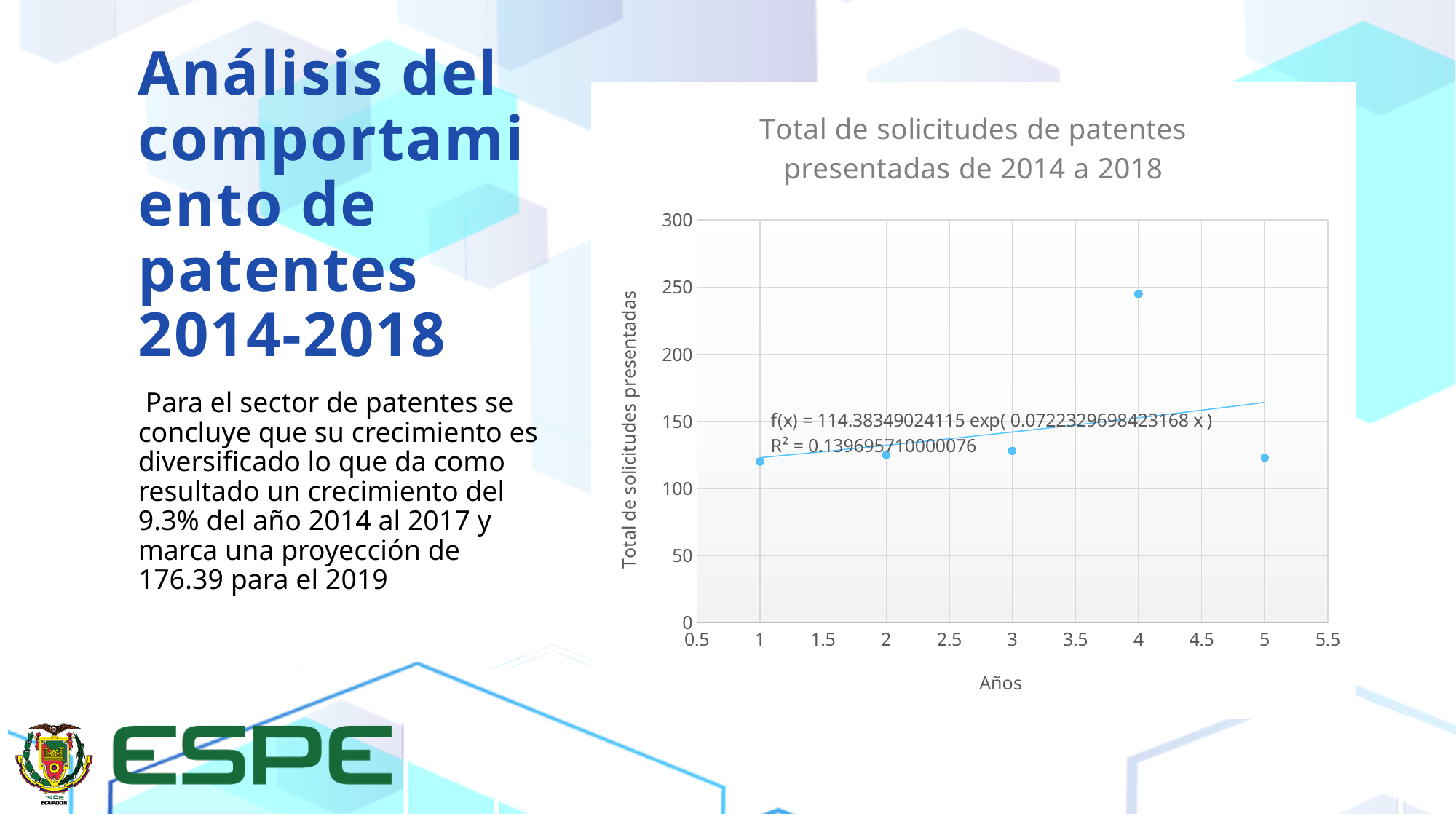
At which x value (Años) is the highest point plotted? 4 What R² value is printed on the chart for the trendline? R² = 0.139695710000076 Is the value at x = 1 greater or less than 150? less What is the label of the vertical axis? Total de solicitudes presentadas How many data points are plotted in the chart? 5 Is the value at x = 4 greater or less than 200? greater Which point has a larger value, the one at x = 2 or the one at x = 4? x = 4 What is the title of the chart? Total de solicitudes de patentes presentadas de 2014 a 2018 Does the fitted trendline rise or fall as x increases? rise Is the value at x = 3 greater or less than 100? greater What kind of chart is shown on the slide? scatter chart